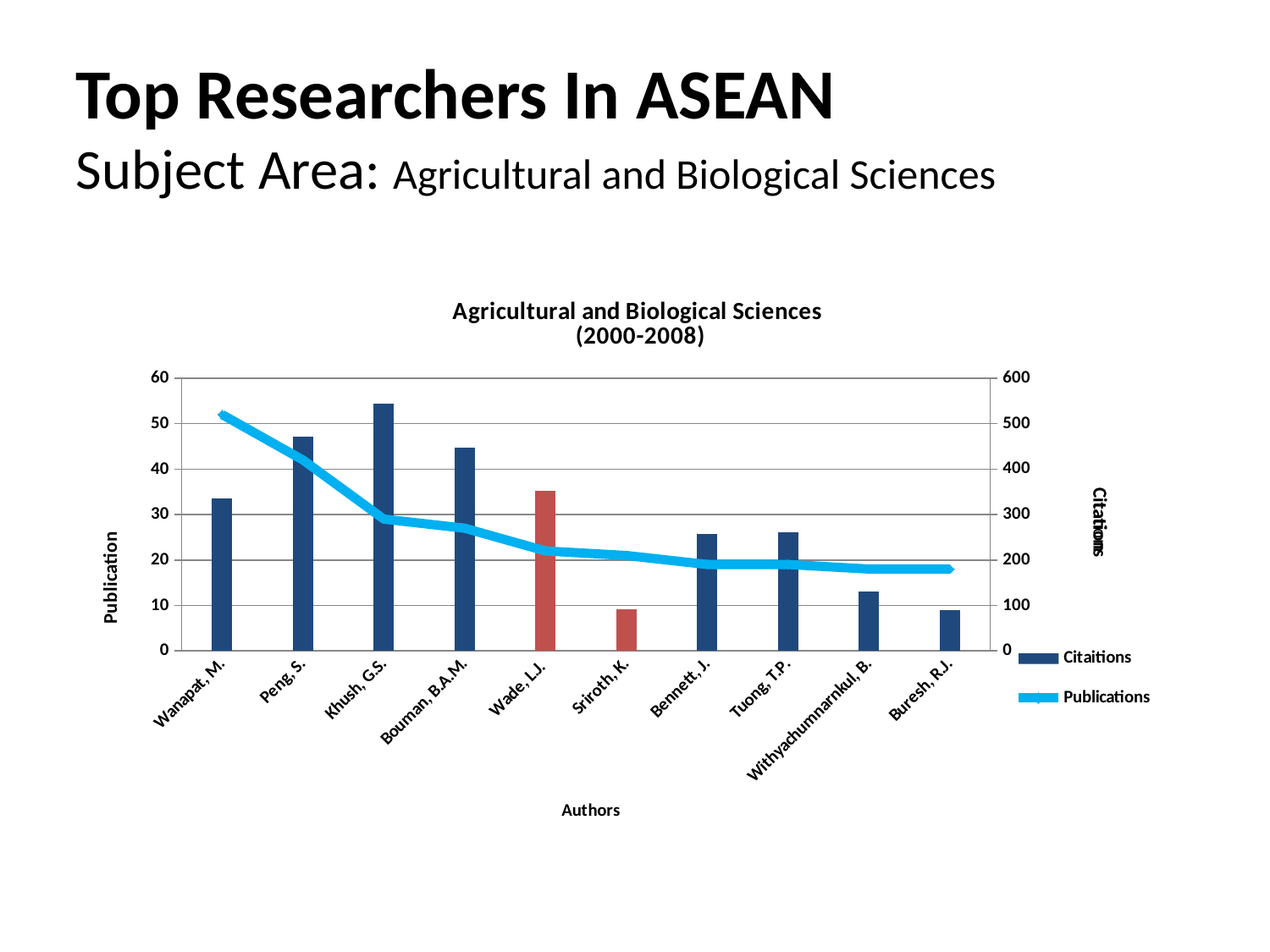
Is the citations value for Khush, G.S. greater or less than 500? greater Who has more citations, Peng, S. or Wanapat, M.? Peng, S. Is the citations value for Sriroth, K. greater or less than 100? less What is the title of the chart? Agricultural and Biological Sciences (2000-2008) How many series does the chart legend list? 2 Does the Publications line rise or fall from left to right across the authors? It falls Which author has the highest number of publications according to the line? Wanapat, M. Which author has the highest number of citations (tallest bar)? Khush, G.S. What type of chart is shown on the slide? A combination bar and line chart Is the publications value for Wanapat, M. greater or less than 40? greater How many authors are shown on the x axis of the chart? 10